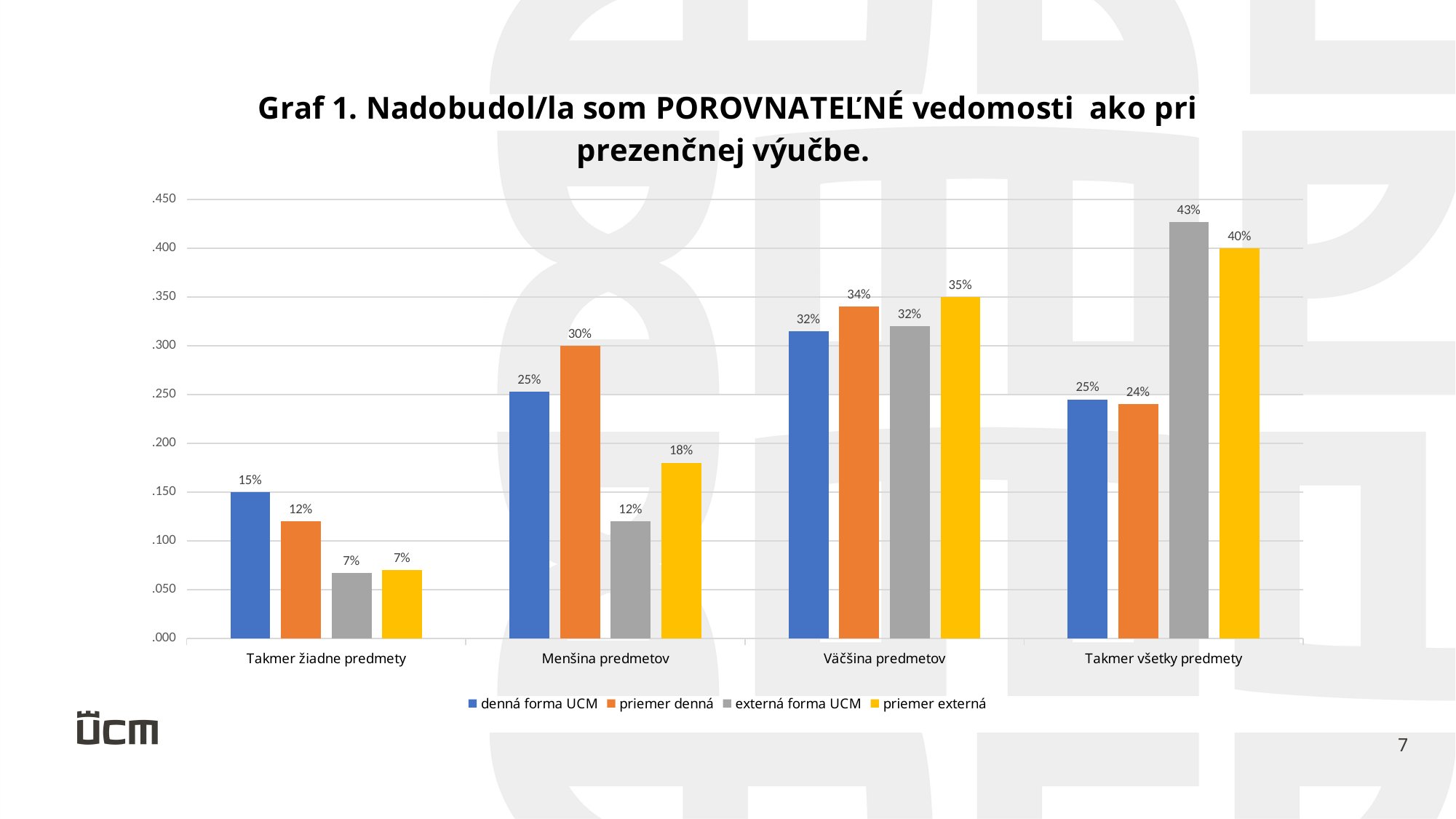
Which category has the lowest value for the 'priemer denná' series? Takmer žiadne predmety How many series does the legend list? 4 What is the value for 'denná forma UCM' in the 'Takmer žiadne predmety' category? 15% What is the value for 'externá forma UCM' in the 'Takmer všetky predmety' category? 43% What kind of chart is shown on the slide? bar chart What is the value for 'priemer externá' in the 'Väčšina predmetov' category? 35% What is the difference between 'externá forma UCM' and 'denná forma UCM' in the 'Takmer všetky predmety' category? 18% In the 'Menšina predmetov' category, which is larger: 'priemer denná' or 'priemer externá'? priemer denná Which category has the highest value for the 'externá forma UCM' series? Takmer všetky predmety How many categories are shown on the x axis? 4 Which colour represents the 'priemer externá' series? yellow What is the value for 'priemer denná' in the 'Menšina predmetov' category? 30%